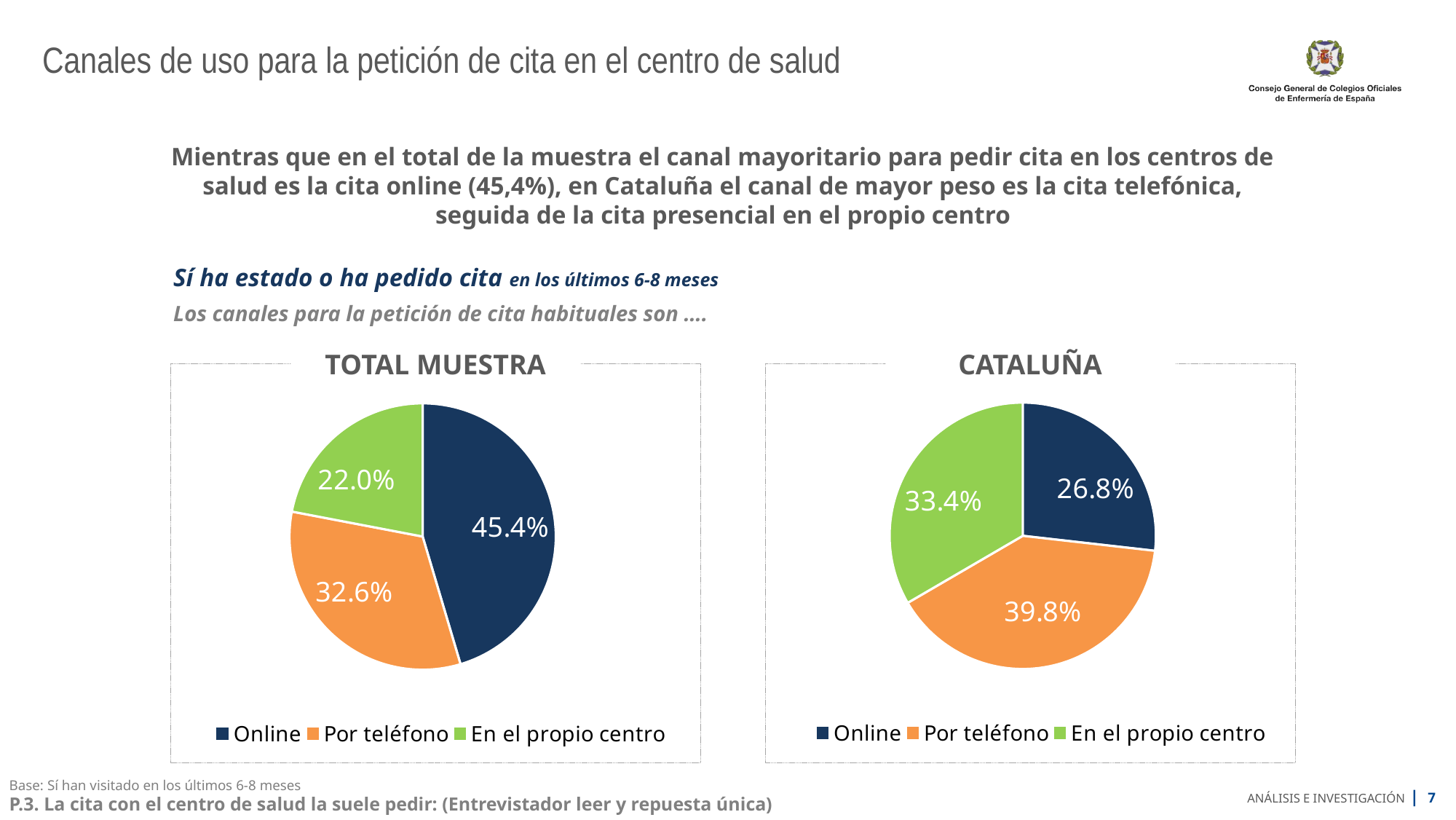
What is the difference between the Online share in the TOTAL MUESTRA chart and the Online share in the CATALUÑA chart? 18.6% In the CATALUÑA pie chart, which category has the smallest share? Online How many slices does the CATALUÑA pie chart have? 3 In the TOTAL MUESTRA pie chart, which is larger: Por teléfono or En el propio centro? Por teléfono In the CATALUÑA pie chart, which category has the largest share? Por teléfono In the TOTAL MUESTRA chart legend, which colour represents Por teléfono? Orange In the TOTAL MUESTRA pie chart, what is the value for Por teléfono? 32.6% In the TOTAL MUESTRA pie chart, which category has the smallest share? En el propio centro In the TOTAL MUESTRA pie chart, what is the value for Online? 45.4% What kind of chart is the TOTAL MUESTRA chart? Pie chart In the CATALUÑA pie chart, what is the value for En el propio centro? 33.4% In the CATALUÑA pie chart, what is the value for Por teléfono? 39.8%